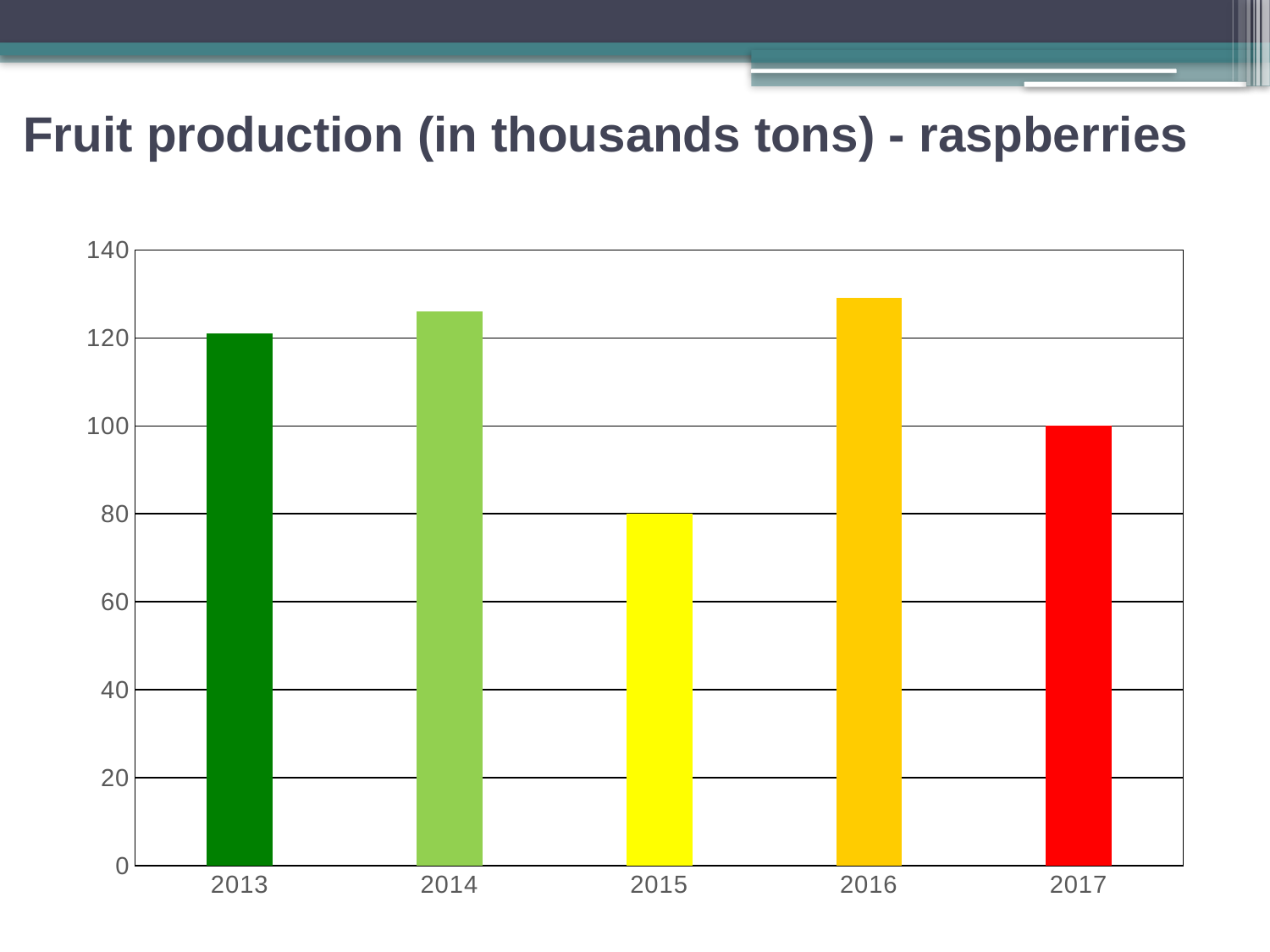
Does raspberry production rise or fall from 2016 to 2017? fall Which year has the lowest raspberry production? 2015 What is the difference between the values for 2017 and 2015? 20 How many years are shown on the x axis of the chart? 5 Is the value for 2016 greater or less than 120? greater What is the raspberry production value for 2017? 100 Which year has the larger raspberry production, 2013 or 2015? 2013 What is the raspberry production value for 2015? 80 What kind of chart is shown on the slide? bar chart Which year has the highest raspberry production? 2016 Is the value for 2014 greater or less than 140? less